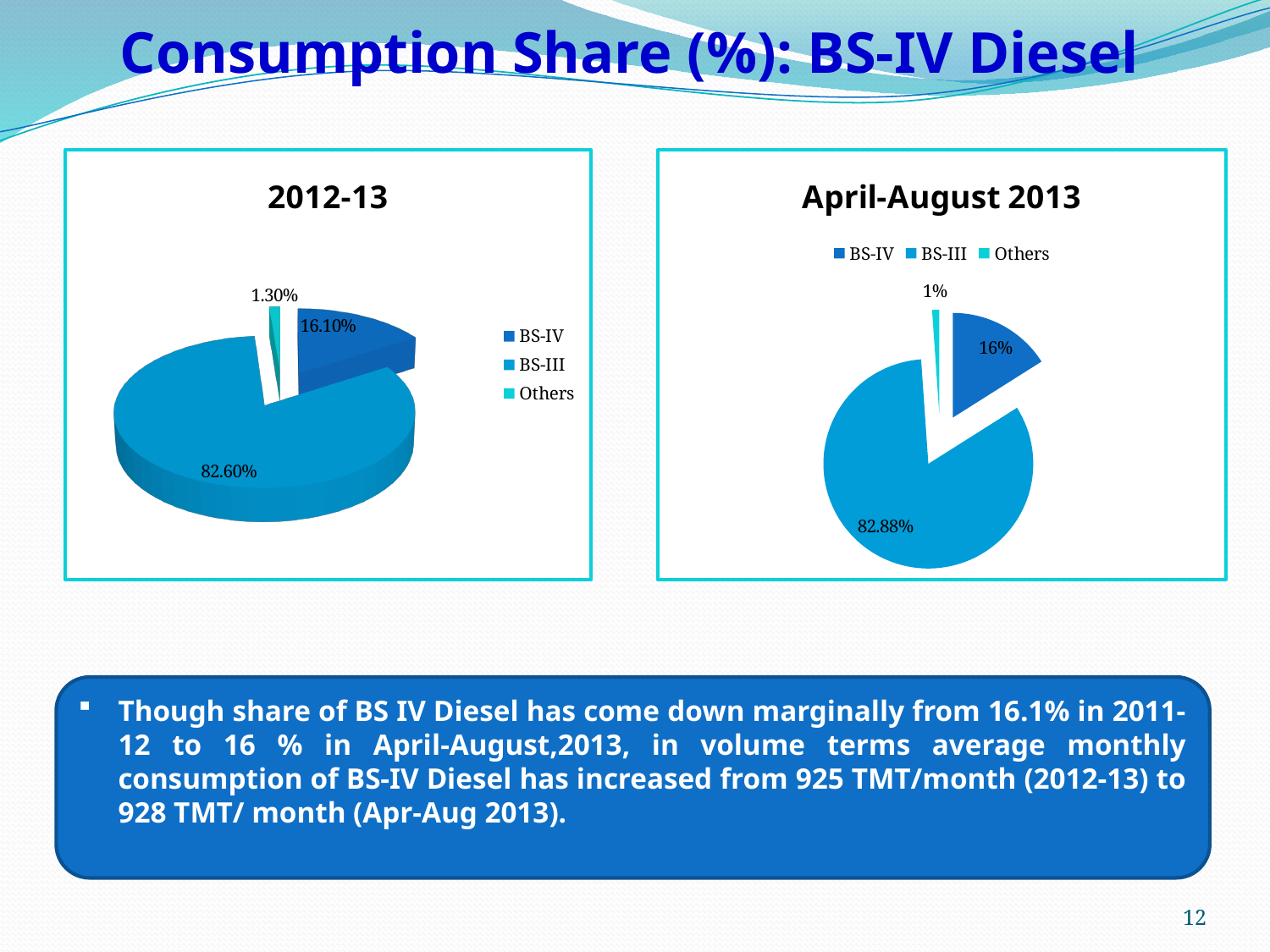
In the 2012-13 chart, what is the share for Others? 1.30% What type of chart is the April-August 2013 chart? Pie chart In the 2012-13 chart, what is the share for BS-III? 82.60% In the 2012-13 chart, which category has the largest share? BS-III In the 2012-13 chart, what is the share for BS-IV? 16.10% In the April-August 2013 chart, which category has the smallest share? Others In the April-August 2013 chart, what is the share for Others? 1% In the April-August 2013 chart, which is larger, the share for BS-IV or the share for Others? BS-IV In the April-August 2013 chart, what is the share for BS-IV? 16% In the April-August 2013 chart, what is the share for BS-III? 82.88% In the 2012-13 chart, what is the difference between the BS-III share and the BS-IV share? 66.50% How many categories does the legend of the 2012-13 chart list? 3